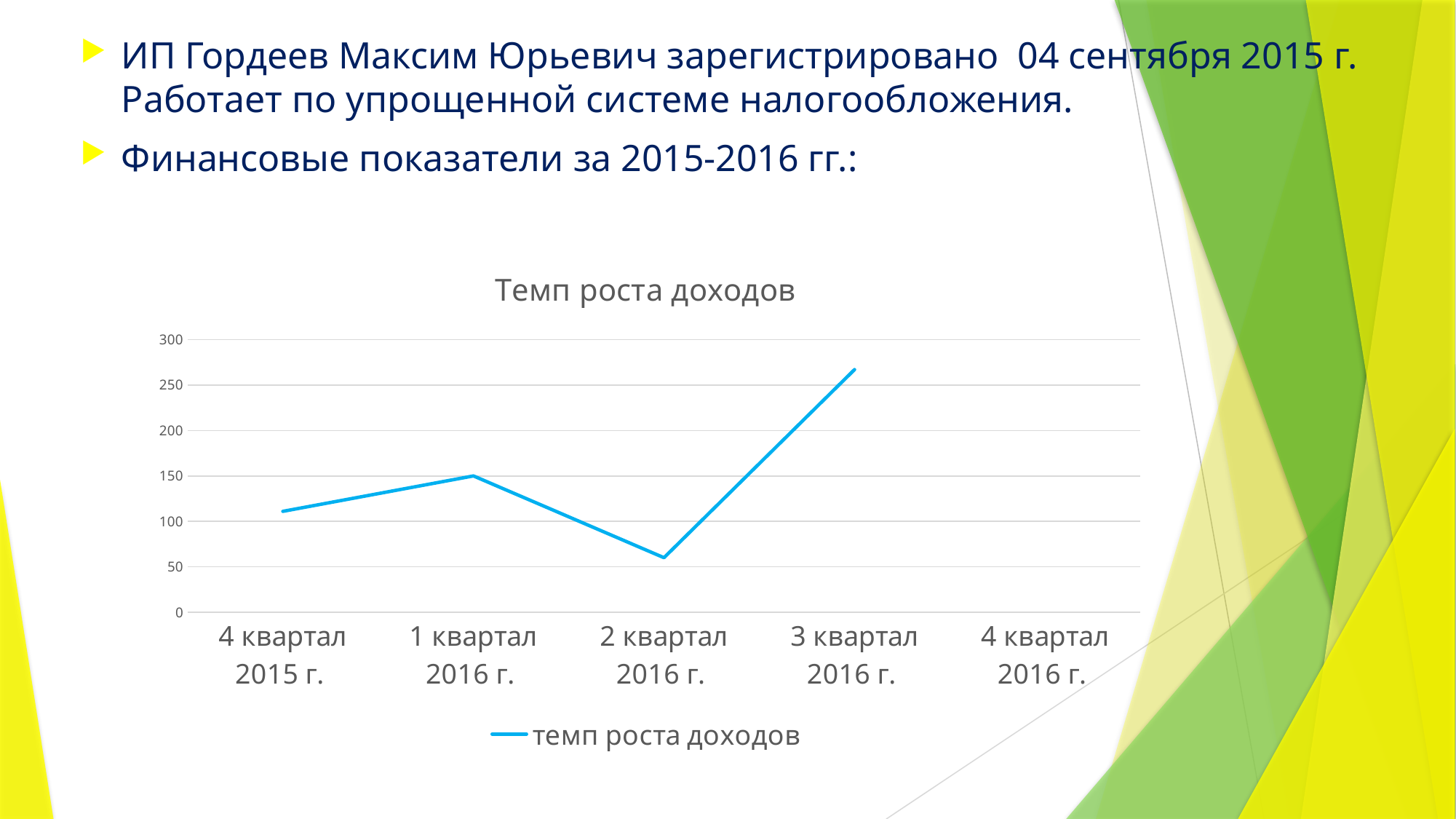
Which quarter has the highest value for темп роста доходов? 3 квартал 2016 г. How many categories are labelled on the x axis? 5 Is the value for 4 квартал 2015 г. greater or less than 100? greater What is the title of the chart? Темп роста доходов Does the value rise or fall from 2 квартал 2016 г. to 3 квартал 2016 г.? rise Is the value for 3 квартал 2016 г. greater or less than 250? greater What kind of chart is shown on the slide? line chart How many series does the legend list? 1 Which quarter has the lowest plotted value for темп роста доходов? 2 квартал 2016 г. What is the name of the series shown in the legend? темп роста доходов Is the value for 2 квартал 2016 г. greater or less than 100? less Which is larger, the value for 1 квартал 2016 г. or the value for 2 квартал 2016 г.? 1 квартал 2016 г.